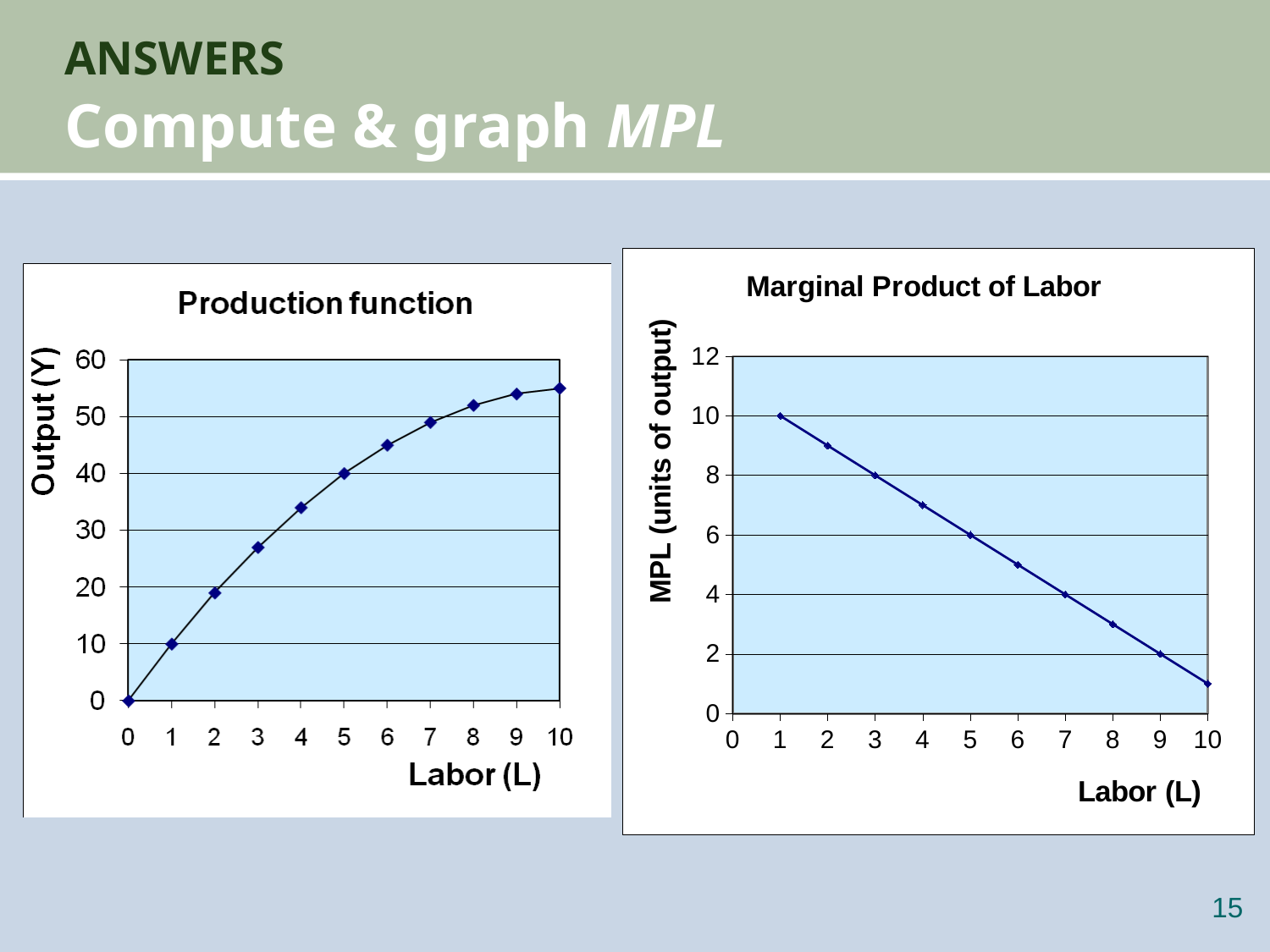
In the Production function chart, does output rise or fall as labor increases? rise In the Marginal Product of Labor chart, does MPL rise or fall as labor increases? fall In the Production function chart, what is the output when labor is 5? 40 In the Marginal Product of Labor chart, what is MPL when labor is 9? 2 In the Marginal Product of Labor chart, what is MPL when labor is 5? 6 In the Marginal Product of Labor chart, what is MPL when labor is 1? 10 In the Production function chart, what is the output when labor is 1? 10 What type of chart is the Marginal Product of Labor chart? line chart In the Production function chart, is the output at labor 8 greater or less than 50? greater In the Production function chart, is the output at labor 3 greater or less than 30? less In the Marginal Product of Labor chart, at which labor level is MPL lowest? 10 In the Production function chart, what is the output when labor is 0? 0